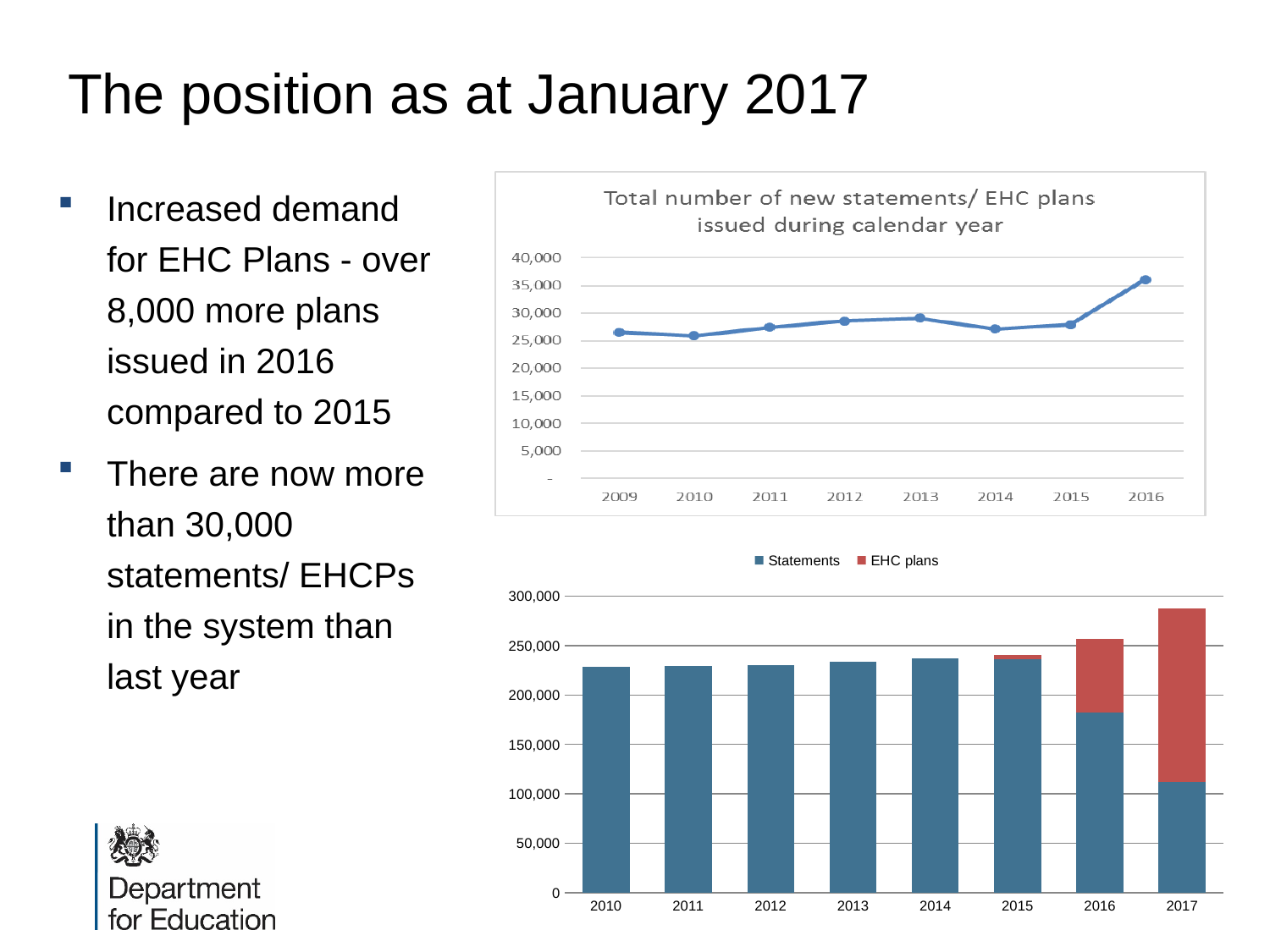
In the bottom chart, which colour represents EHC plans? red In the top chart, is the value for 2016 greater or less than 35,000? greater In the bottom chart, how many years are shown on the x axis? 8 What kind of chart is the top chart titled 'Total number of new statements/ EHC plans issued during calendar year'? line chart In the bottom chart, is the Statements value for 2017 greater or less than 150,000? less What kind of chart is the bottom chart with the Statements and EHC plans legend? stacked bar chart In the top chart, which is larger, the value for 2015 or the value for 2016? 2016 In the top chart, how many years are plotted along the x axis? 8 In the bottom chart, how many series does the legend list? 2 In the top chart, is the value for 2014 greater or less than 30,000? less In the bottom chart, which year has the tallest stacked bar? 2017 In the top chart, which year has the highest number of new statements/EHC plans issued? 2016